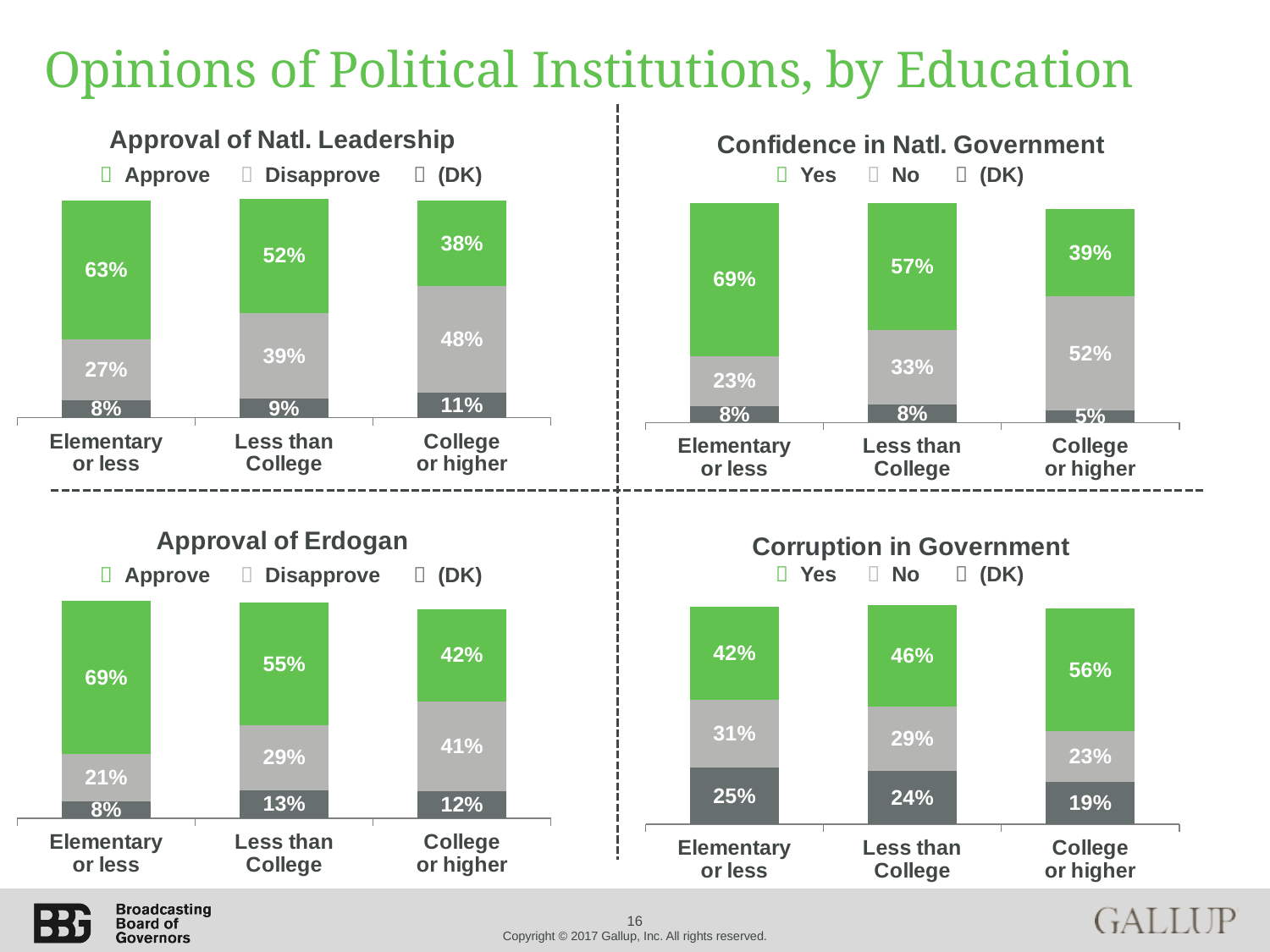
What kind of chart is the 'Corruption in Government' chart? Stacked bar chart In the 'Corruption in Government' chart, which is larger for 'College or higher': the Yes value or the No value? Yes In the 'Approval of Erdogan' chart, what is the (DK) value for 'Less than College'? 13% In the 'Confidence in Natl. Government' chart, which education group has the lowest (DK) value? College or higher How many series does the legend of the 'Confidence in Natl. Government' chart list? 3 In the 'Approval of Natl. Leadership' chart, what is the difference between the Disapprove values for 'College or higher' and 'Elementary or less'? 21% In the 'Corruption in Government' chart, what is the Yes value for 'Less than College'? 46% In the 'Approval of Erdogan' chart, which education group has the highest Approve value? Elementary or less In the 'Approval of Natl. Leadership' chart, what is the Approve value for 'Elementary or less'? 63% How many education groups are shown in the 'Approval of Erdogan' chart? 3 In the 'Confidence in Natl. Government' chart, what is the No value for 'College or higher'? 52% In the 'Approval of Natl. Leadership' chart, do the Approve values rise or fall from 'Elementary or less' to 'College or higher'? Fall